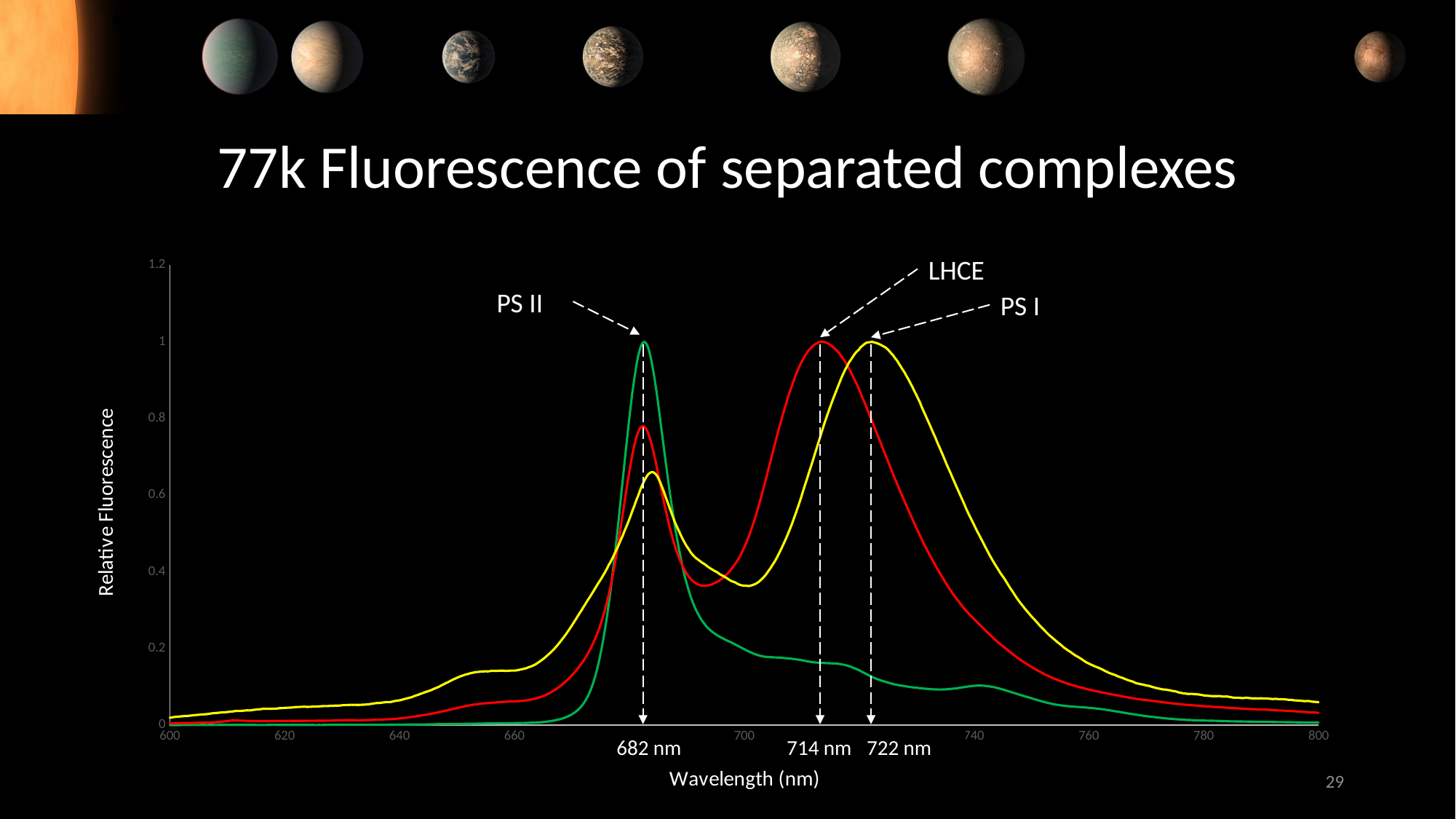
How many curves (complexes) are plotted on the chart? 3 What is the label of the x axis? Wavelength (nm) Which complex has its peak at the longest wavelength? PS I At what wavelength does the PS I curve peak? 722 nm What kind of chart is shown on the slide? line chart At 682 nm, which curve has the higher relative fluorescence, PS II (green) or PS I (yellow)? PS II How many nanometres apart are the peaks of PS II and PS I? 40 nm At what wavelength does the PS II curve peak? 682 nm Which complex has its peak at the shortest wavelength? PS II What is the title of the chart on the slide? 77k Fluorescence of separated complexes At what wavelength does the LHCE curve peak? 714 nm Is the relative fluorescence of the PS II (green) curve at 740 nm greater or less than 0.2? less